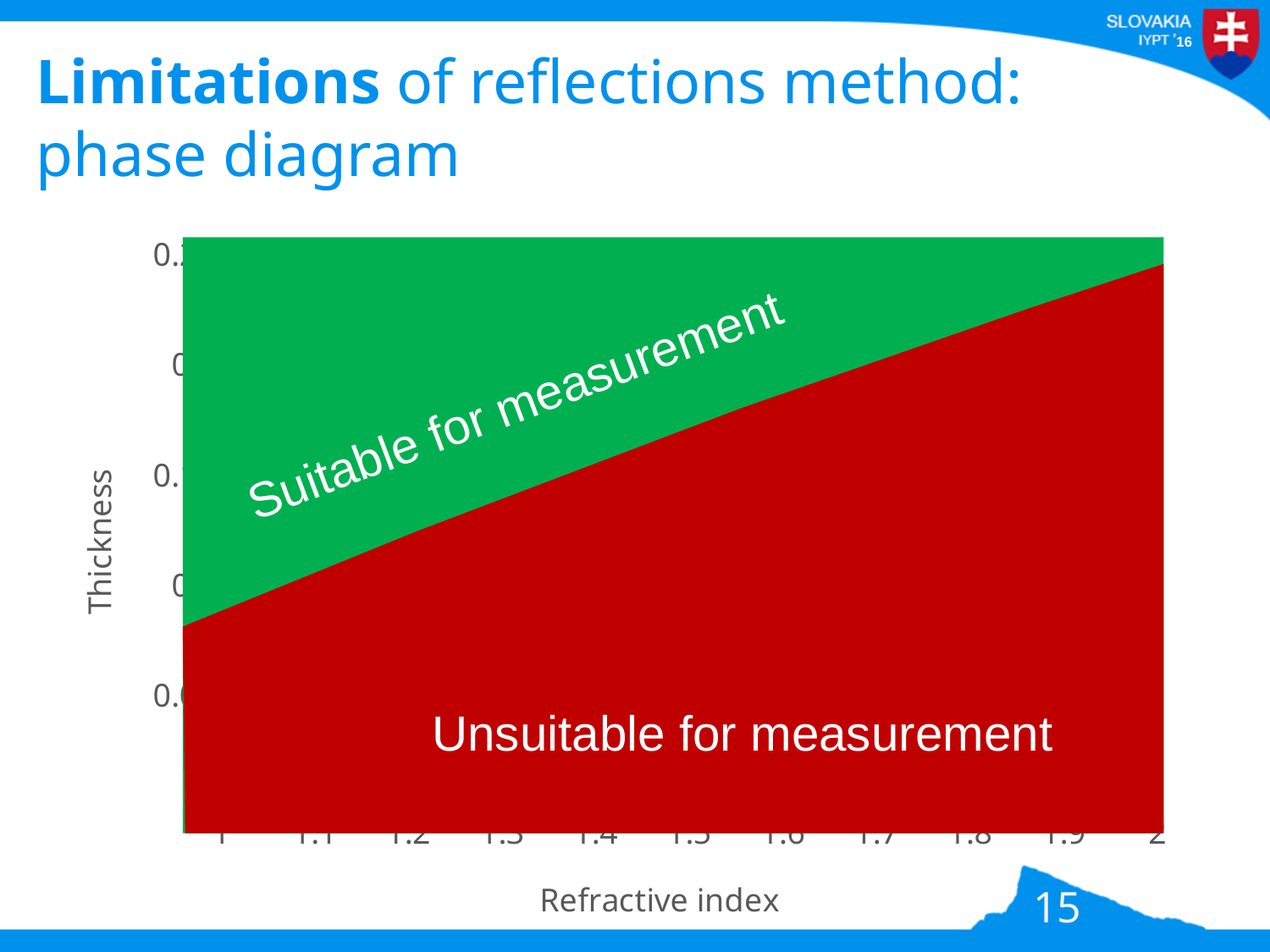
What is the label of the y axis of the phase diagram? Thickness What is the highest refractive index value shown on the x axis of the phase diagram? 2 Which region occupies the upper part of the phase diagram, suitable or unsuitable for measurement? Suitable for measurement What is the label of the x axis of the phase diagram? Refractive index Does the boundary between the suitable and unsuitable regions rise or fall as the refractive index increases? rise How many regions are marked on the phase diagram? 2 Is the minimum thickness suitable for measurement larger at a refractive index of 2 or at a refractive index of 1? 2 What is the lowest refractive index value shown on the x axis of the phase diagram? 1